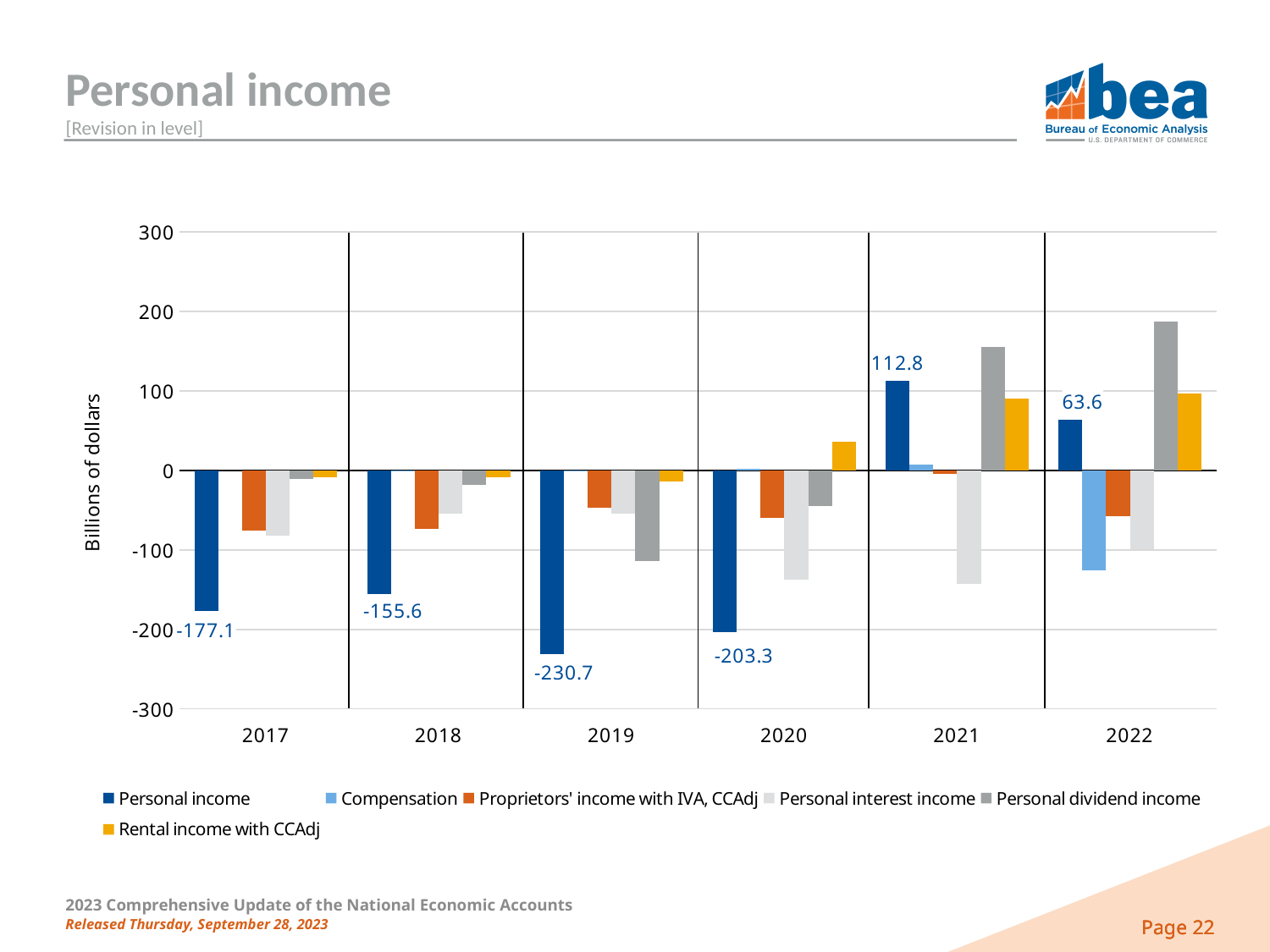
In which year is the Personal income revision lowest? 2019 Is the value for Personal interest income in 2021 greater or less than -100? less What is the value for Personal income in 2017? -177.1 In which year is the Personal income revision highest? 2021 How many series does the legend list? 6 What is the difference between the Personal income values for 2021 and 2022? 49.2 What is the value for Personal income in 2019? -230.7 How many years are shown on the x axis? 6 Is the value for Personal dividend income in 2022 greater or less than 100? greater What is the value for Personal income in 2021? 112.8 Which year has the larger Personal income value, 2017 or 2018? 2018 What kind of chart is shown on the slide? bar chart